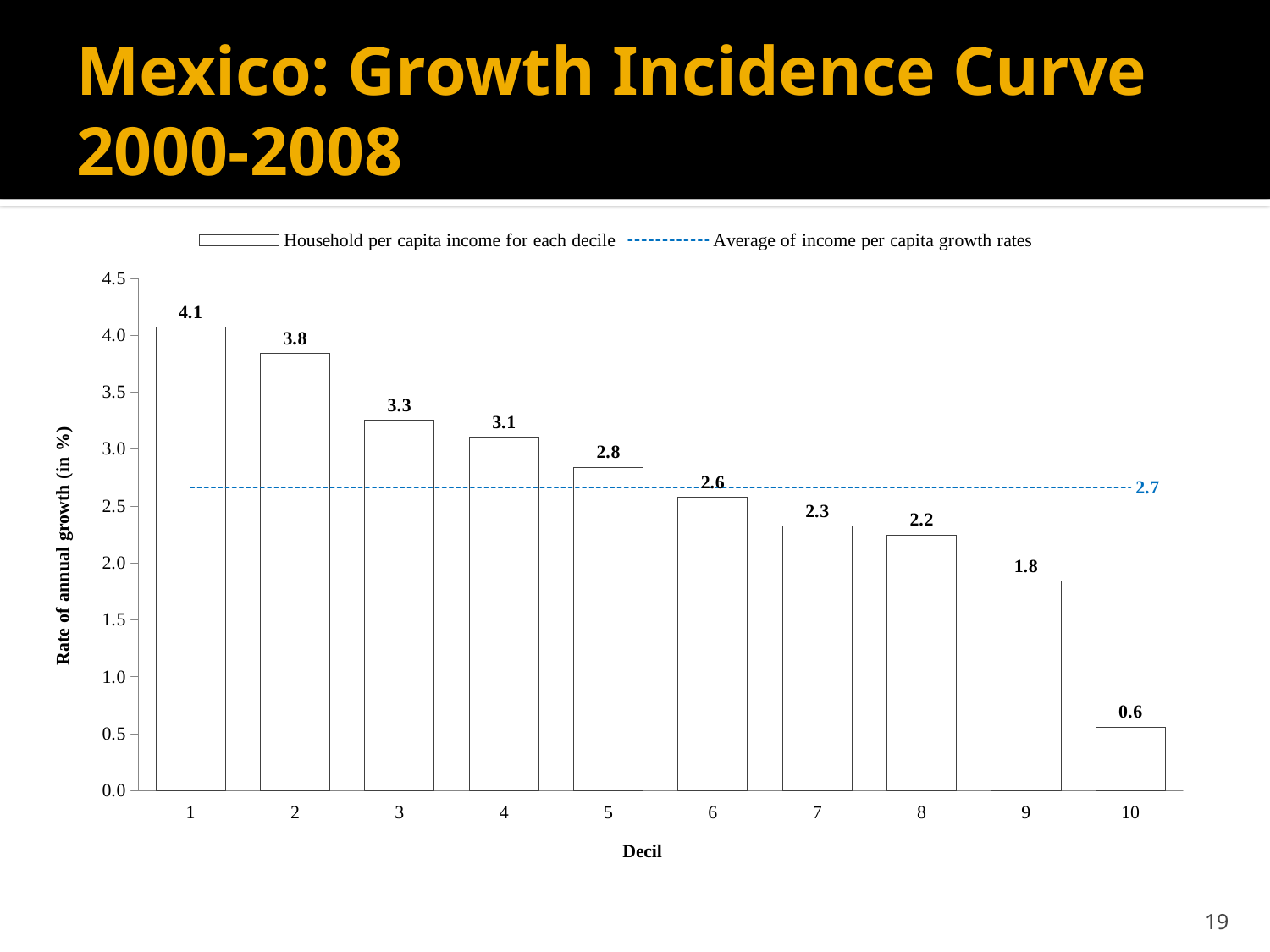
How many deciles are shown on the x axis? 10 What kind of chart is this? Combination bar and line chart What is the rate of annual growth for decile 5? 2.8 Do the growth rates rise or fall as the decile increases from 1 to 10? Fall What is the rate of annual growth for decile 10? 0.6 Which decile has the lowest rate of annual growth? 10 Which decile has the highest rate of annual growth? 1 How many entries does the legend list? 2 What is the rate of annual growth for decile 1? 4.1 What is the difference between the growth rates of decile 1 and decile 10? 3.5 Which has a higher rate of annual growth, decile 3 or decile 7? Decile 3 What value is shown for the average of income per capita growth rates line? 2.7